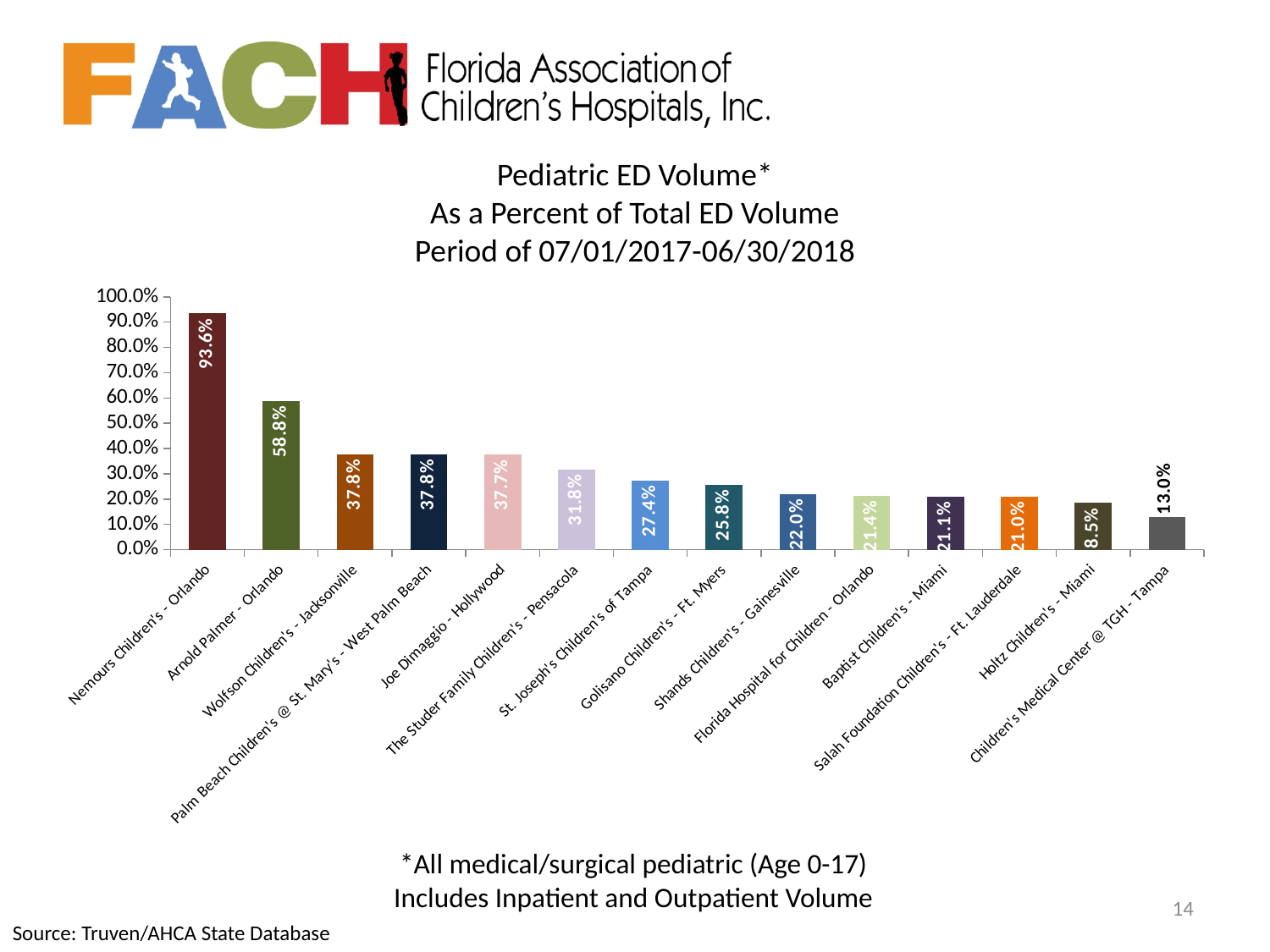
Which hospital has the lowest pediatric ED volume as a percent of total ED volume? Children's Medical Center @ TGH - Tampa What value is shown for Arnold Palmer - Orlando? 58.8% Which hospital has the highest pediatric ED volume as a percent of total ED volume? Nemours Children's - Orlando What is the pediatric ED volume percentage for Nemours Children's - Orlando? 93.6% What type of chart is used on this slide? bar chart What is the value for Children's Medical Center @ TGH - Tampa? 13.0% What percentage is shown for Shands Children's - Gainesville? 22.0% Is the value for The Studer Family Children's - Pensacola greater or less than 40.0%? less What period does the chart title say the data covers? 07/01/2017-06/30/2018 How many hospitals are shown in the chart? 14 What is the difference between the values for Nemours Children's - Orlando and Arnold Palmer - Orlando? 34.8% Which is larger, the value for Golisano Children's - Ft. Myers or the value for St. Joseph's Children's of Tampa? St. Joseph's Children's of Tampa